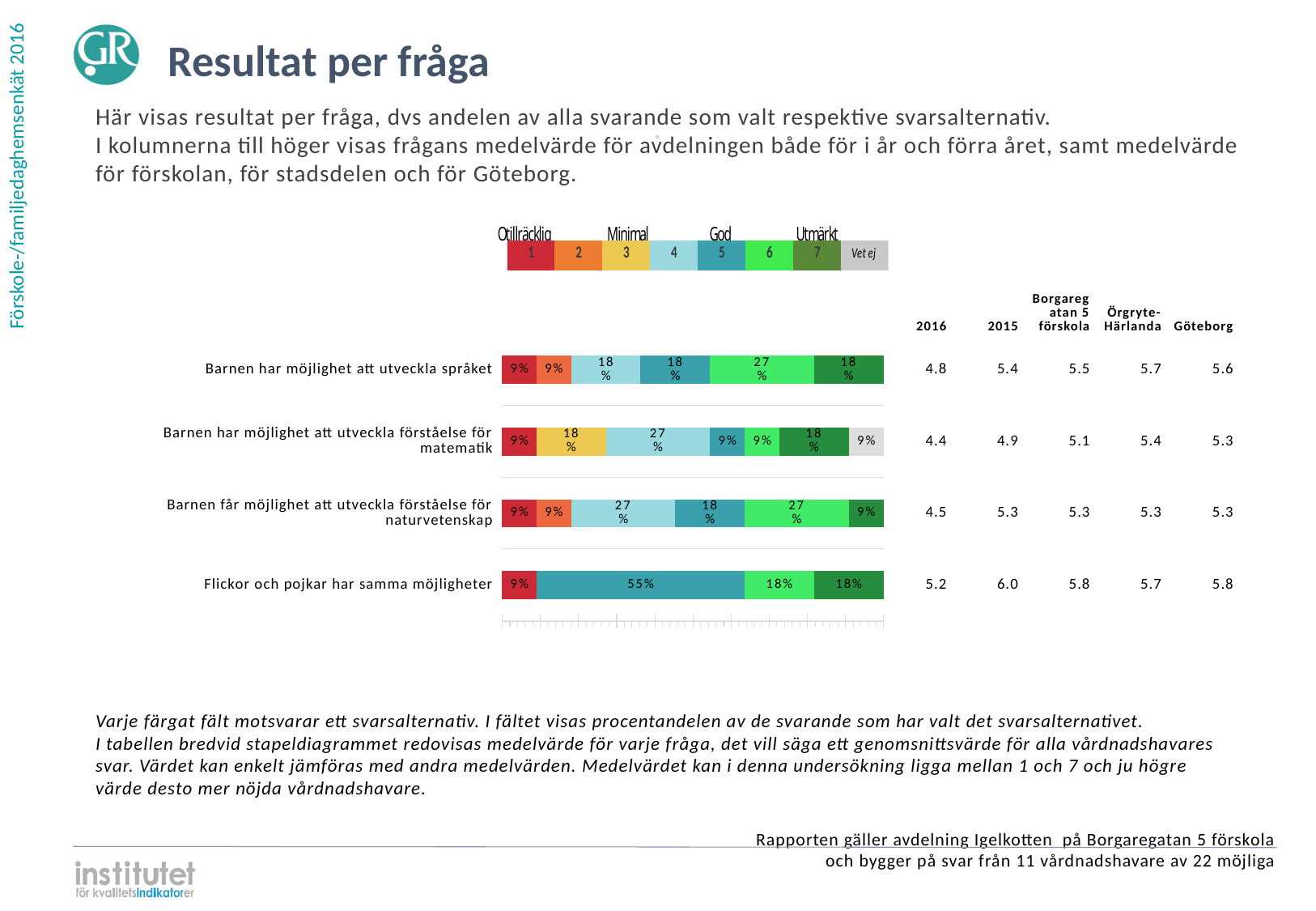
How many response options does the legend above the chart list, including 'Vet ej'? 8 What percentage chose option 6 (bright green) for 'Barnen har möjlighet att utveckla språket'? 27% What percentage chose option 4 (light blue) for 'Barnen får möjlighet att utveckla förståelse för naturvetenskap'? 27% What is the 2016 mean value shown for 'Flickor och pojkar har samma möjligheter'? 5.2 For 'Barnen har möjlighet att utveckla språket', what is the difference between the option 6 share (27%) and the option 7 share (18%)? 9 percentage points What share of respondents answered 'Vet ej' for 'Barnen har möjlighet att utveckla förståelse för matematik'? 9% Which single segment in the chart has the largest percentage? 55% (option 5, Flickor och pojkar har samma möjligheter) Which question has the lowest 2016 mean value in the table next to the chart? Barnen har möjlighet att utveckla förståelse för matematik (4.4) Which is larger for 'Barnen har möjlighet att utveckla förståelse för matematik': the option 3 (yellow) share or the option 4 (light blue) share? Option 4 (27%) What kind of chart is shown on the slide? Stacked bar chart How many questions (categories) are plotted as bars in the chart? 4 What percentage of respondents chose option 5 (teal) for 'Flickor och pojkar har samma möjligheter'? 55%